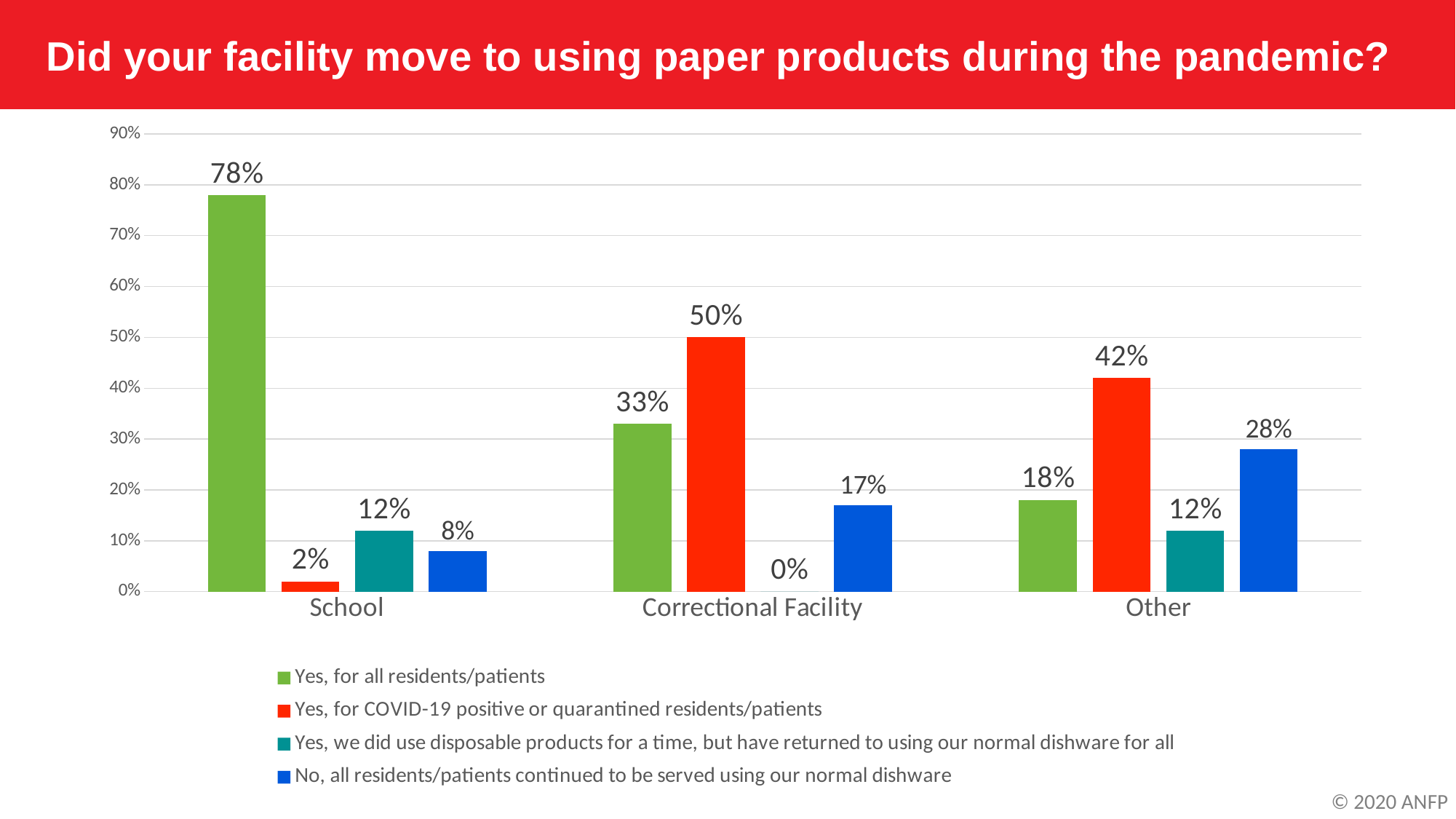
What percentage of correctional facilities answered "Yes, for COVID-19 positive or quarantined residents/patients"? 50% What percentage of schools answered "Yes, for all residents/patients"? 78% How many facility types are shown on the x axis? 3 How many series does the legend list? 4 What kind of chart is shown on the slide? Bar chart Which facility type has the lowest value for "Yes, for COVID-19 positive or quarantined residents/patients"? School What percentage of "Other" facilities answered "No, all residents/patients continued to be served using our normal dishware"? 28% Which is larger for "Other" facilities: "Yes, for COVID-19 positive or quarantined residents/patients" or "Yes, for all residents/patients"? Yes, for COVID-19 positive or quarantined residents/patients What is the title of the chart? Did your facility move to using paper products during the pandemic? What percentage of correctional facilities answered "Yes, we did use disposable products for a time, but have returned to using our normal dishware for all"? 0% What is the difference between the "Yes, for all residents/patients" values for School and Correctional Facility? 45% Which facility type has the highest value for "Yes, for all residents/patients"? School